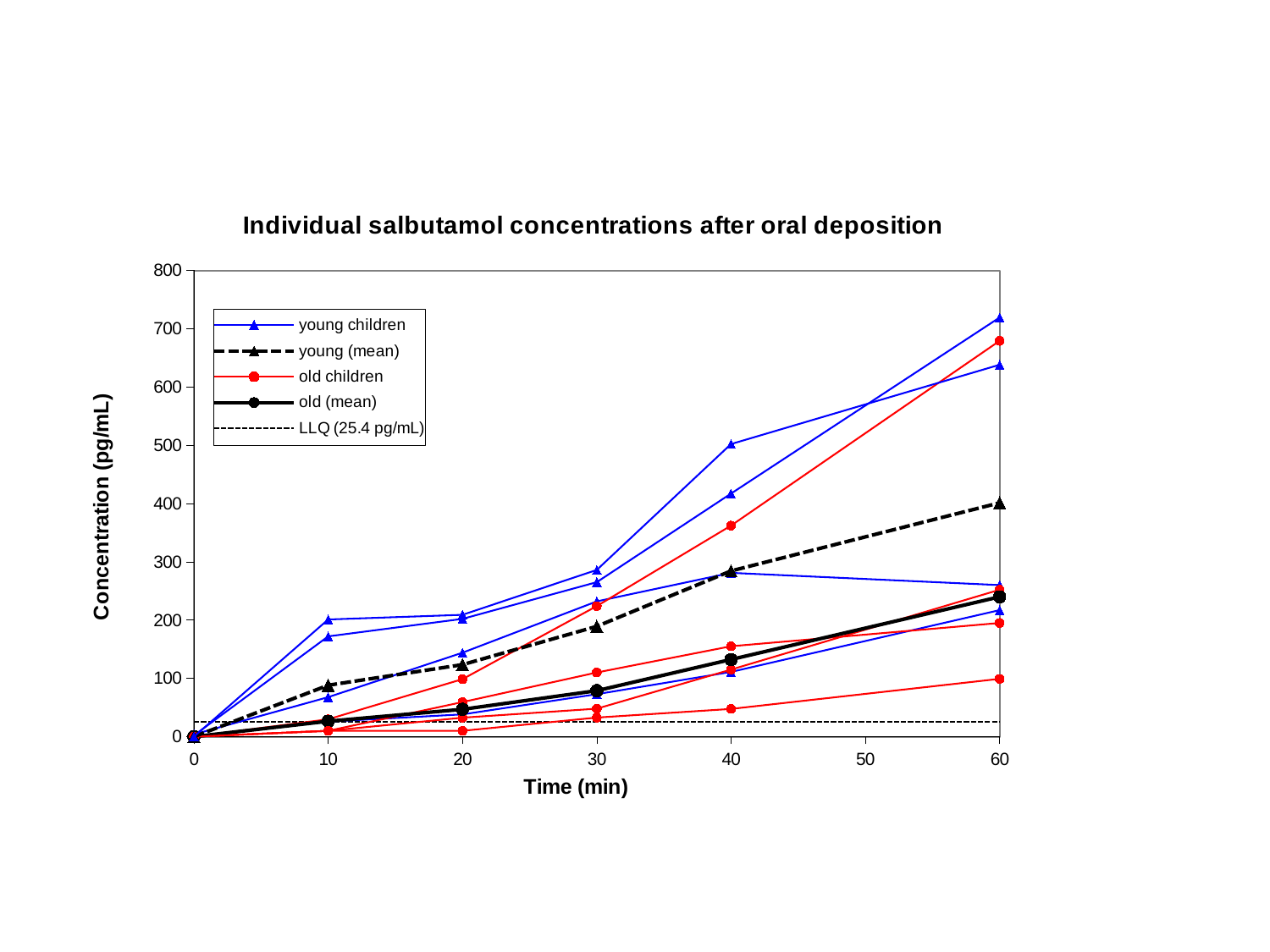
How many time points are plotted for the old (mean) series? 6 What is the title of the chart? Individual salbutamol concentrations after oral deposition How many series does the legend list? 5 Is the value of the old (mean) series at 30 min greater or less than 100? less What is the LLQ value given in the legend? 25.4 pg/mL What kind of chart is shown on the slide? line chart Is the value of the young (mean) series at 10 min greater or less than 100? less Does the young (mean) series rise or fall as time increases from 0 to 60 min? rise What is the label of the y axis? Concentration (pg/mL) Is the value of the young (mean) series at 40 min greater or less than 200? greater At 60 min, which is higher: the young (mean) series or the old (mean) series? young (mean)